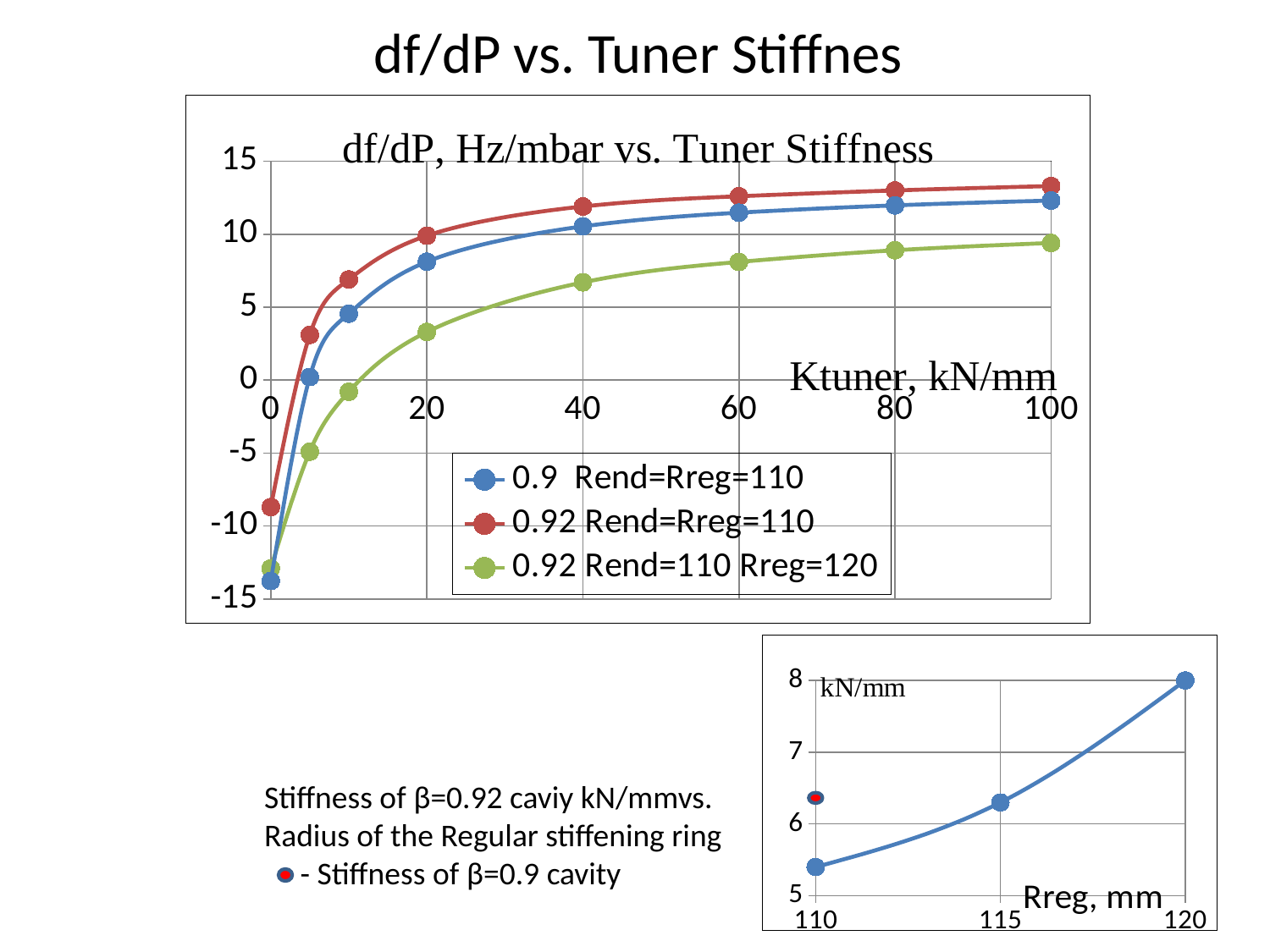
In the top chart (df/dP, Hz/mbar vs. Tuner Stiffness), which series has the lowest value at Ktuner = 100 kN/mm? 0.92 Rend=110 Rreg=120 In the top chart (df/dP, Hz/mbar vs. Tuner Stiffness), what is the label of the x axis? Ktuner, kN/mm In the top chart (df/dP, Hz/mbar vs. Tuner Stiffness), how many series does the legend list? 3 In the bottom-right chart (stiffness vs. Rreg), is the stiffness at Rreg = 110 mm greater or less than 6? less In the top chart (df/dP, Hz/mbar vs. Tuner Stiffness), is the value of the 0.92 Rend=110 Rreg=120 series at Ktuner = 100 greater or less than 10? less In the top chart (df/dP, Hz/mbar vs. Tuner Stiffness), which series has the highest value at Ktuner = 100 kN/mm? 0.92 Rend=Rreg=110 In the bottom-right chart (stiffness vs. Rreg), does the stiffness rise or fall as Rreg increases? Rise In the top chart (df/dP, Hz/mbar vs. Tuner Stiffness), what kind of chart is shown? Line chart In the top chart (df/dP, Hz/mbar vs. Tuner Stiffness), do the df/dP values rise or fall as Ktuner increases? Rise In the top chart (df/dP, Hz/mbar vs. Tuner Stiffness), is the value of the 0.92 Rend=Rreg=110 series at Ktuner = 40 greater or less than 10? greater In the bottom-right chart (stiffness vs. Rreg), what is the stiffness value at Rreg = 120 mm? 8 In the bottom-right chart (stiffness vs. Rreg), how many data points lie on the plotted line? 3